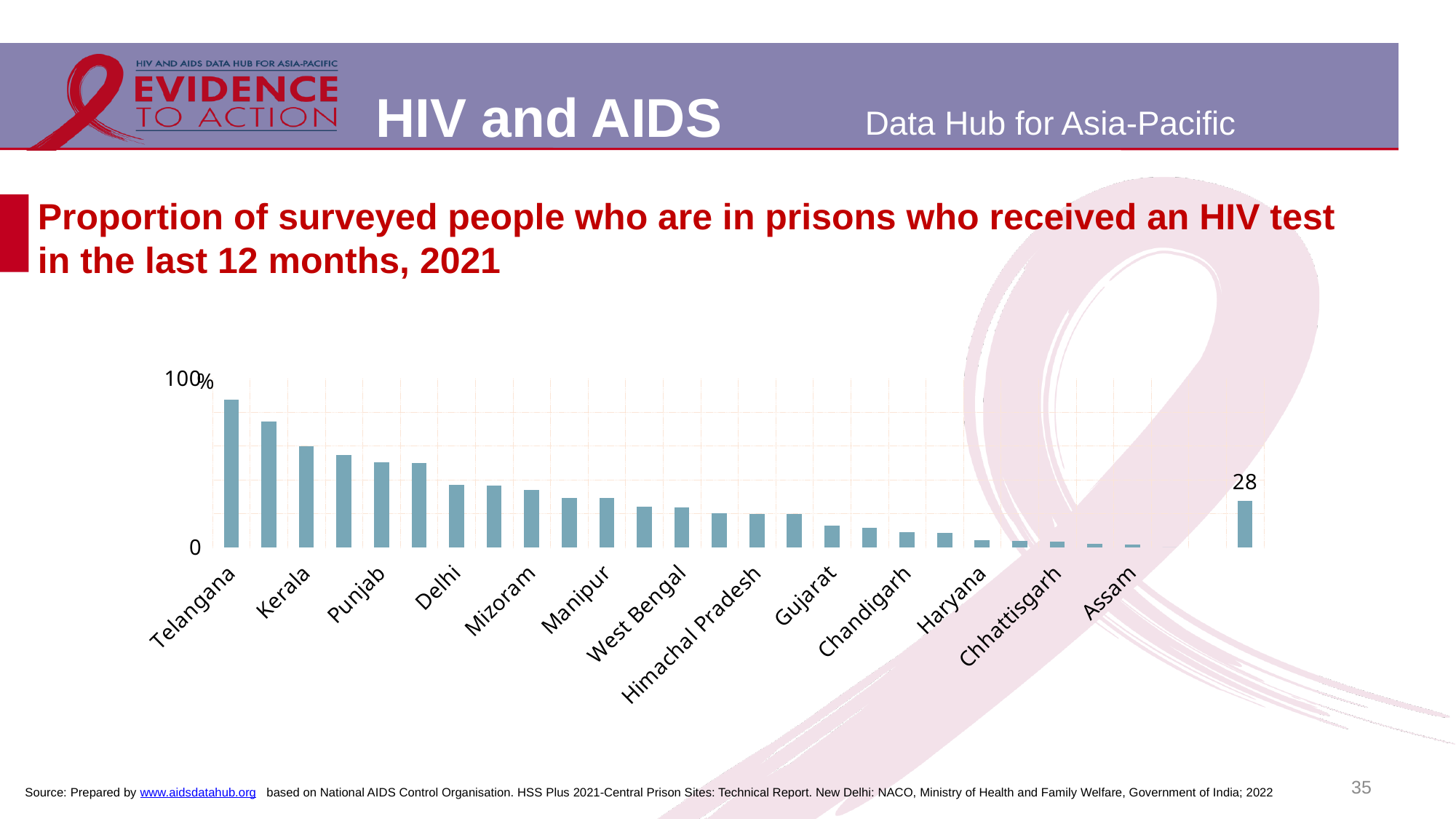
Which is larger, the value for Delhi or the value for Mizoram? Delhi Among the labelled states, which has the lowest proportion of surveyed people in prisons who received an HIV test? Assam What value is printed as a data label on the separate bar at the far right of the chart? 28 Which is larger, the value for Telangana or the value for Kerala? Telangana What is the maximum value shown on the vertical axis? 100% Which is larger, the value for Haryana or the value for Assam? Haryana What year does the chart title say the data refer to? 2021 What kind of chart is shown on the slide? bar chart Which state has the highest proportion of surveyed people in prisons who received an HIV test in the last 12 months? Telangana Do the bar values rise or fall moving from left to right across the states? fall